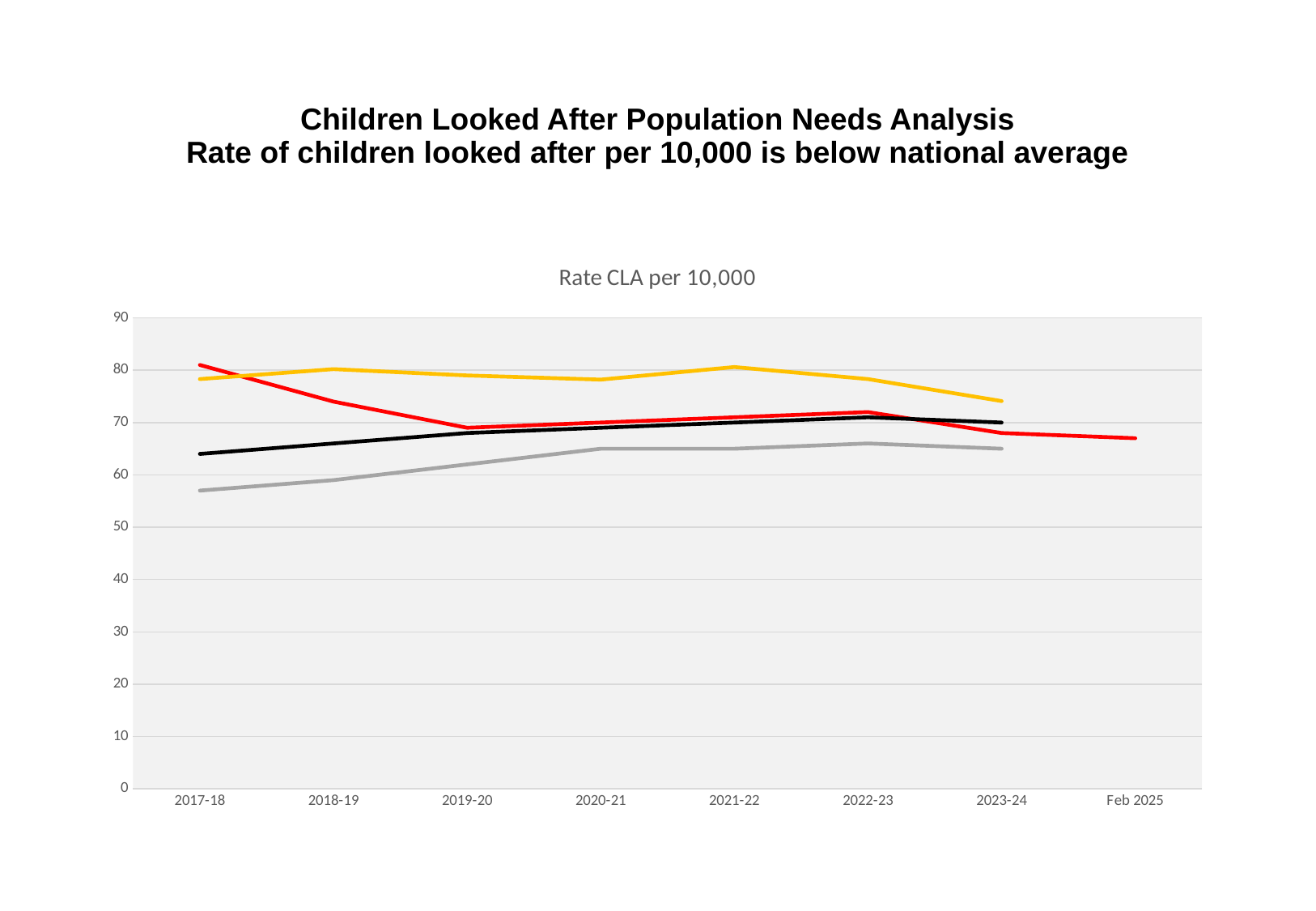
Is the value of the grey line for 2017-18 greater or less than 60? less At 2017-18, which is larger: the red line or the grey line? the red line What is the title of the chart? Rate CLA per 10,000 Does the red line rise or fall between 2017-18 and 2019-20? fall Is the value of the black line for 2017-18 greater or less than 60? greater Which line is the only one that extends to Feb 2025? the red line Does the grey line rise or fall between 2017-18 and 2022-23? rise How many time periods are shown along the x axis of the chart? 8 What kind of chart is shown on the slide? line chart In which period is the grey line at its lowest? 2017-18 Is the value of the yellow line for 2023-24 greater or less than 70? greater